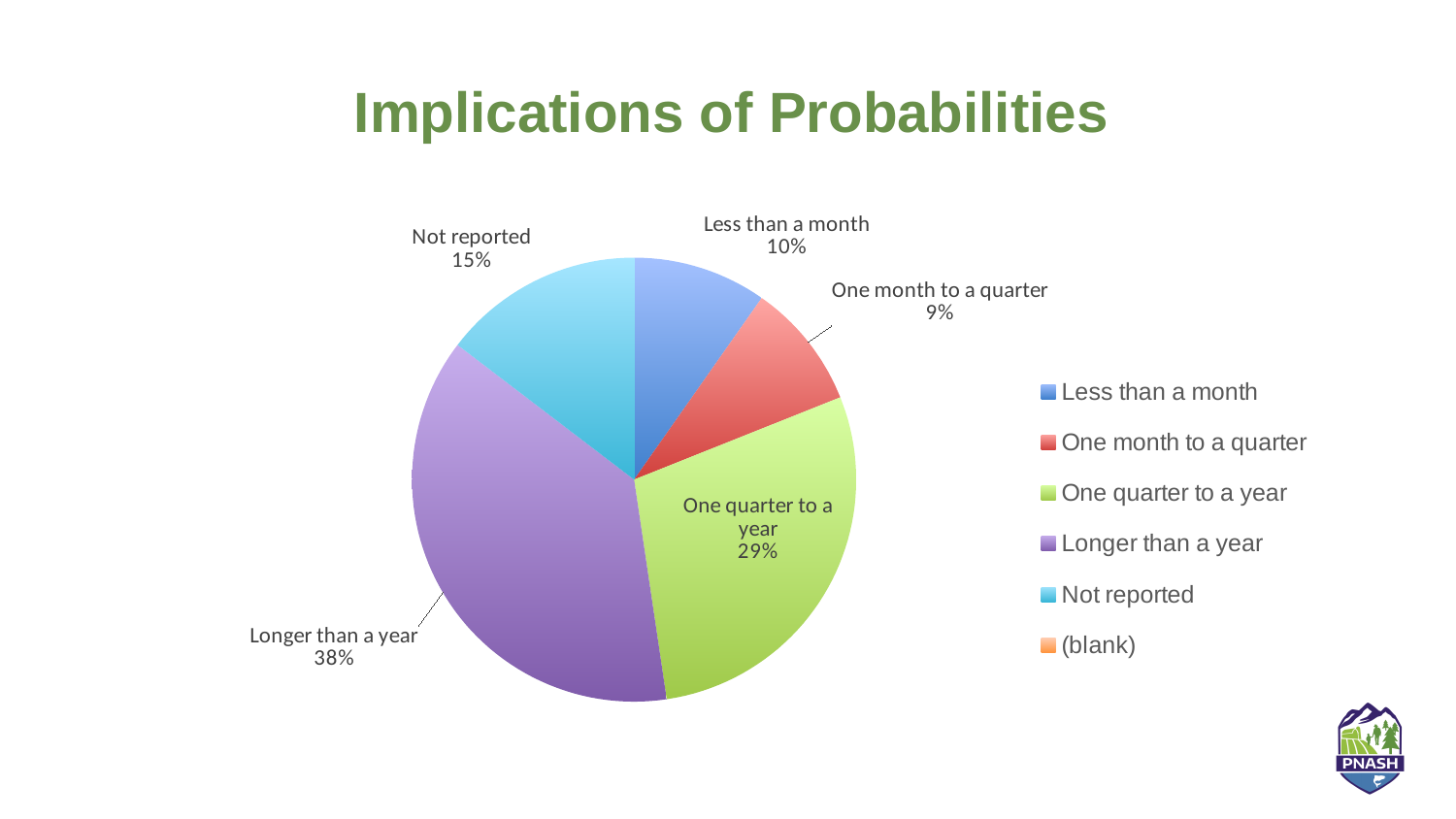
Which is larger, the slice for "Not reported" or the slice for "Less than a month"? Not reported How many entries does the legend list? 6 How many slices with data labels are shown in the pie chart? 5 What percentage is shown for "Less than a month"? 10% What is the difference in percentage points between "Longer than a year" and "One quarter to a year"? 9 What is the title of the slide containing the pie chart? Implications of Probabilities Which category has the largest slice of the pie? Longer than a year Which category has the smallest slice of the pie? One month to a quarter What percentage is shown for "One quarter to a year"? 29% What percentage is shown for "Not reported"? 15% What share of the pie is labelled "Longer than a year"? 38% What type of chart is shown on the slide? pie chart